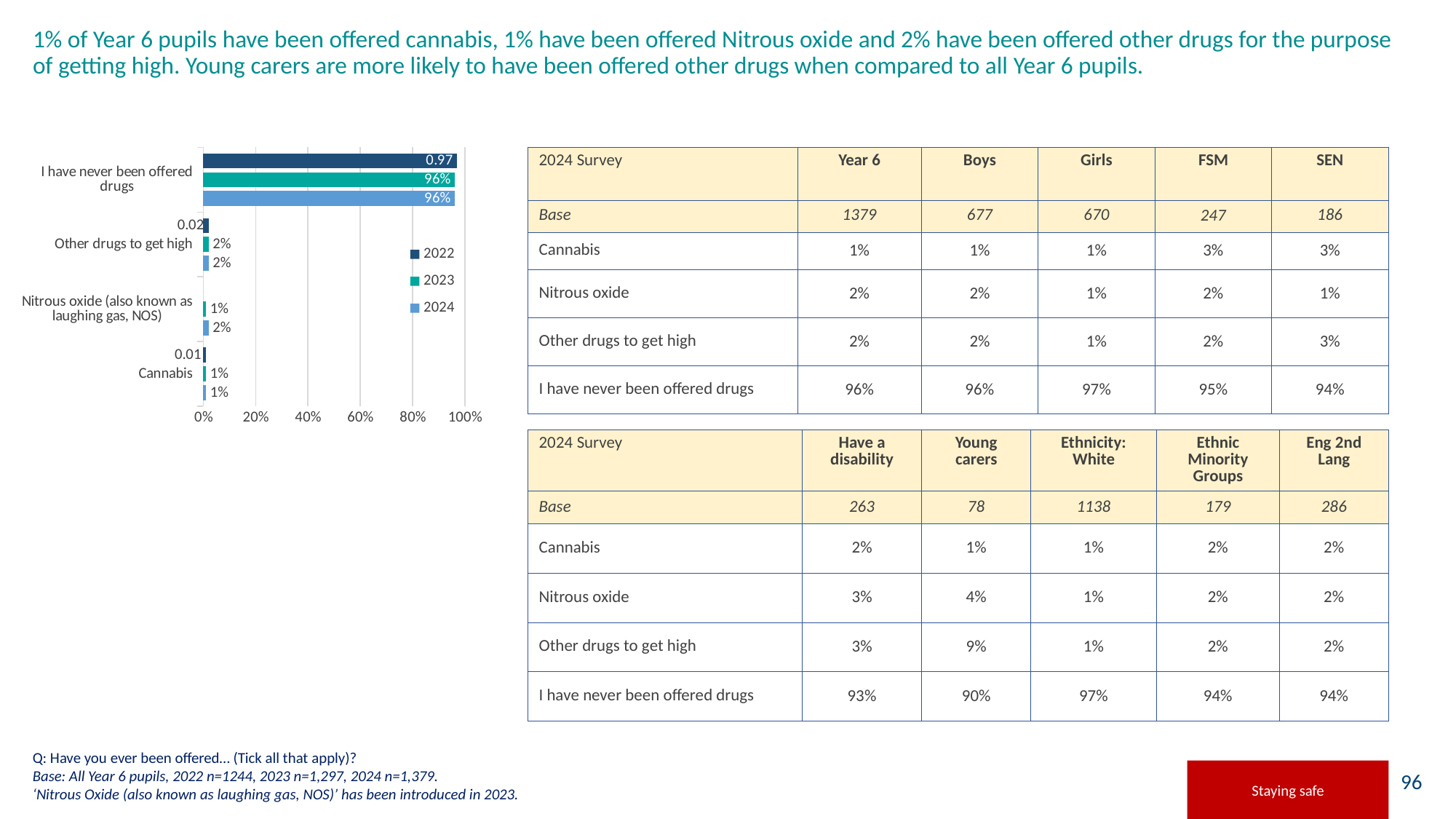
What is the 2022 data label for 'Other drugs to get high' in the chart? 0.02 How many categories are shown on the chart's vertical axis? 4 Which series is shown in the darkest blue colour in the chart legend? 2022 What is the 2022 data label for 'I have never been offered drugs' in the chart? 0.97 What is the 2024 value for 'I have never been offered drugs' in the chart? 96% How many series does the chart legend list? 3 What kind of chart is shown on the slide? bar chart Which category in the chart has no 2022 bar? Nitrous oxide (also known as laughing gas, NOS) Which category has the highest value for the 2024 series in the chart? I have never been offered drugs Is the 2024 value for 'I have never been offered drugs' greater or less than 80%? greater What is the 2024 value for 'Nitrous oxide (also known as laughing gas, NOS)' in the chart? 2% What is the 2023 value for 'Nitrous oxide (also known as laughing gas, NOS)' in the chart? 1%